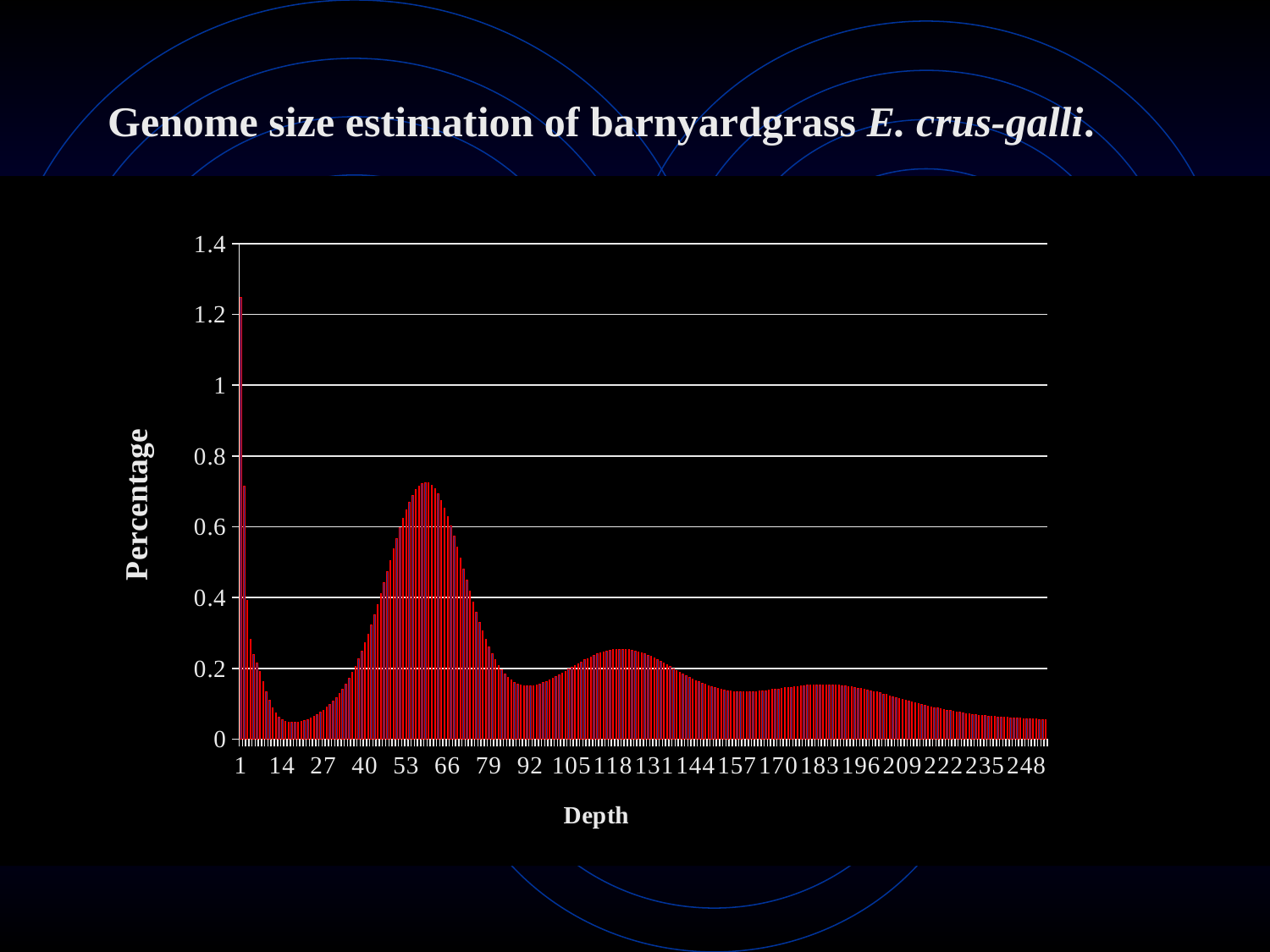
Do the percentages rise or fall as depth increases from 27 to 53? rise What are the x-axis and y-axis titles of the chart? Depth (x-axis) and Percentage (y-axis) Is the percentage at depth 27 greater or less than 0.2? less Do the percentages rise or fall as depth increases from 196 to 248? fall What kind of chart is shown on the slide? bar chart At which depth is the percentage highest? 1 Is the highest percentage in the peak around depth 53-66 greater or less than 0.8? less What is the title of the slide's chart? Genome size estimation of barnyardgrass E. crus-galli. Is the percentage at depth 248 greater or less than 0.2? less Which depth has the larger percentage, 53 or 118? 53 Which depth has the larger percentage, 1 or 66? 1